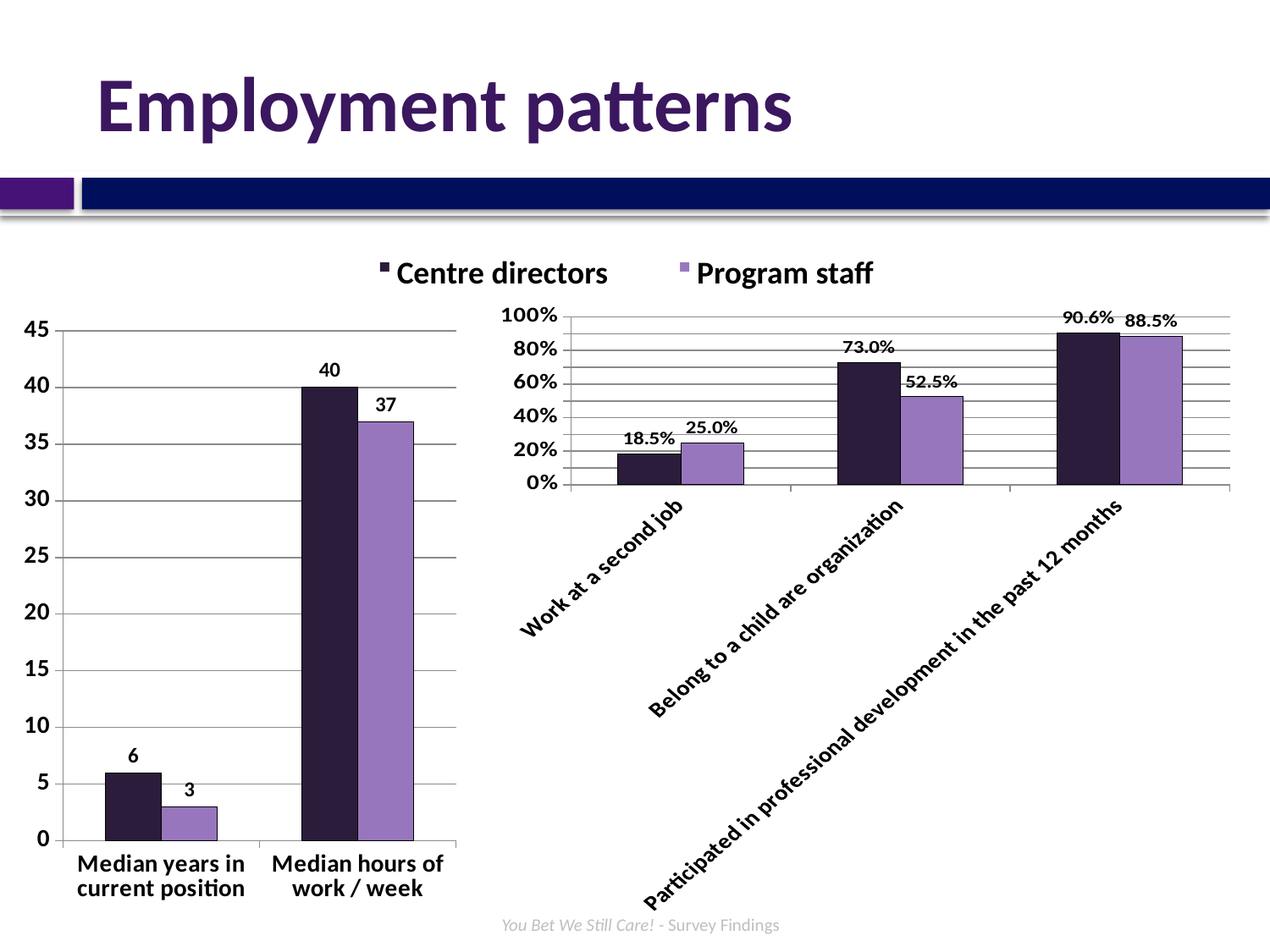
In the left chart, what is the difference between Centre directors and Program staff for median hours of work / week? 3 What type of chart is the right chart? Bar chart In the right chart, which category has the lowest value for Centre directors? Work at a second job In the left chart, which group has the higher median years in current position, Centre directors or Program staff? Centre directors In the right chart, what percentage of Centre directors participated in professional development in the past 12 months? 90.6% In the right chart, which group has the higher value for working at a second job, Centre directors or Program staff? Program staff In the right chart, what percentage of Program staff work at a second job? 25.0% In the left chart, what is the median years in current position for Centre directors? 6 How many series does the legend list? 2 In the right chart, what percentage of Centre directors belong to a child care organization? 73.0% In the left chart, what is the median hours of work per week for Program staff? 37 In the right chart, what is the difference between Centre directors and Program staff for belonging to a child care organization? 20.5%